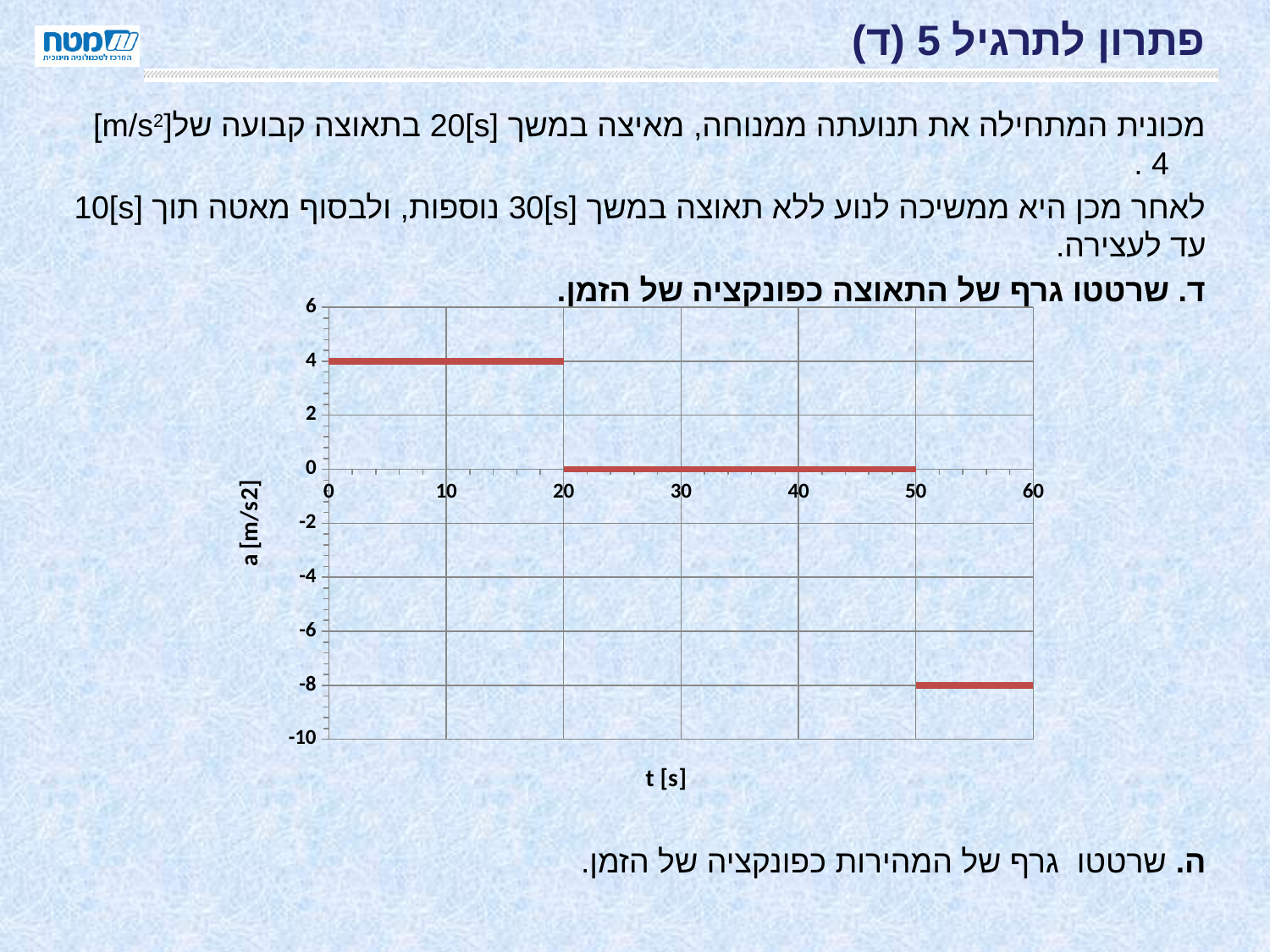
What is the acceleration shown on the graph between t = 20 s and t = 50 s? 0 What is the difference between the acceleration in the first interval (0–20 s) and the last interval (50–60 s)? 12 Does the acceleration rise or fall overall as time increases from 0 to 60 s? fall What is the label of the vertical axis of the chart? a [m/s2] What kind of chart is shown on the slide? line chart How many constant-acceleration segments does the graph show? 3 Which is larger: the acceleration at t = 10 s or the acceleration at t = 55 s? t = 10 s Is the acceleration at t = 55 s greater or less than -6? less What is the acceleration shown on the graph between t = 50 s and t = 60 s? -8 During which time interval is the acceleration lowest? 50 to 60 s What is the acceleration shown on the graph between t = 0 and t = 20 s? 4 During which time interval is the acceleration highest? 0 to 20 s